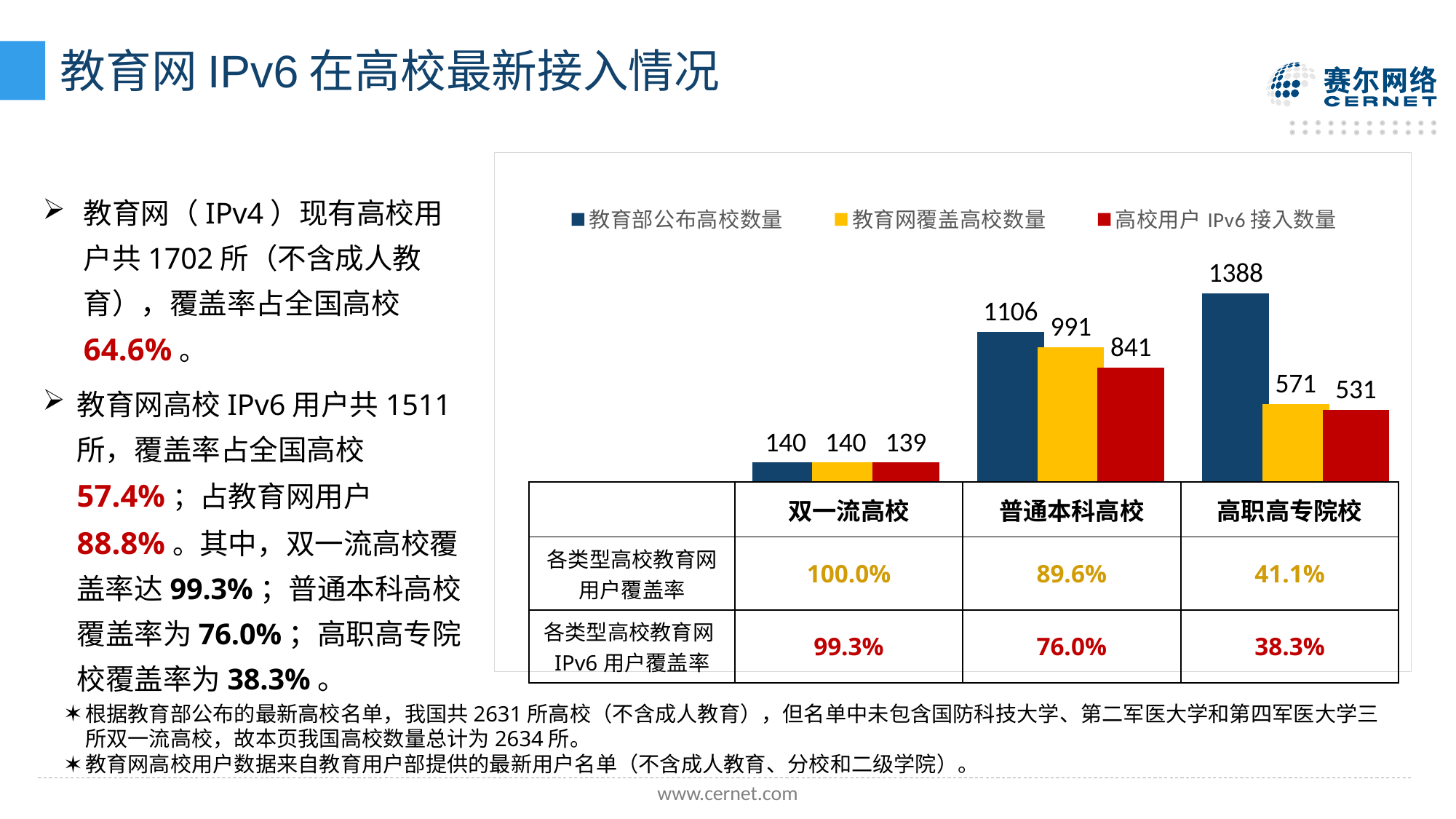
What kind of chart is shown on the slide? bar chart What is the difference between 教育网覆盖高校数量 and 高校用户 IPv6 接入数量 for 普通本科高校? 150 What is the value of 教育网覆盖高校数量 for 普通本科高校? 991 Which category has the lowest value for 高校用户 IPv6 接入数量? 双一流高校 What is the difference between 教育部公布高校数量 and 教育网覆盖高校数量 for 高职高专院校? 817 What is the value of 教育部公布高校数量 for 高职高专院校? 1388 How many series does the chart legend list? 3 Which category has the highest value for 教育部公布高校数量? 高职高专院校 Which is larger: 教育网覆盖高校数量 for 普通本科高校or 教育网覆盖高校数量 for 高职高专院校? 普通本科高校 What is the value of 高校用户 IPv6 接入数量 for 双一流高校? 139 How many categories are shown on the x axis of the chart? 3 What colour are the bars for 高校用户 IPv6 接入数量? red